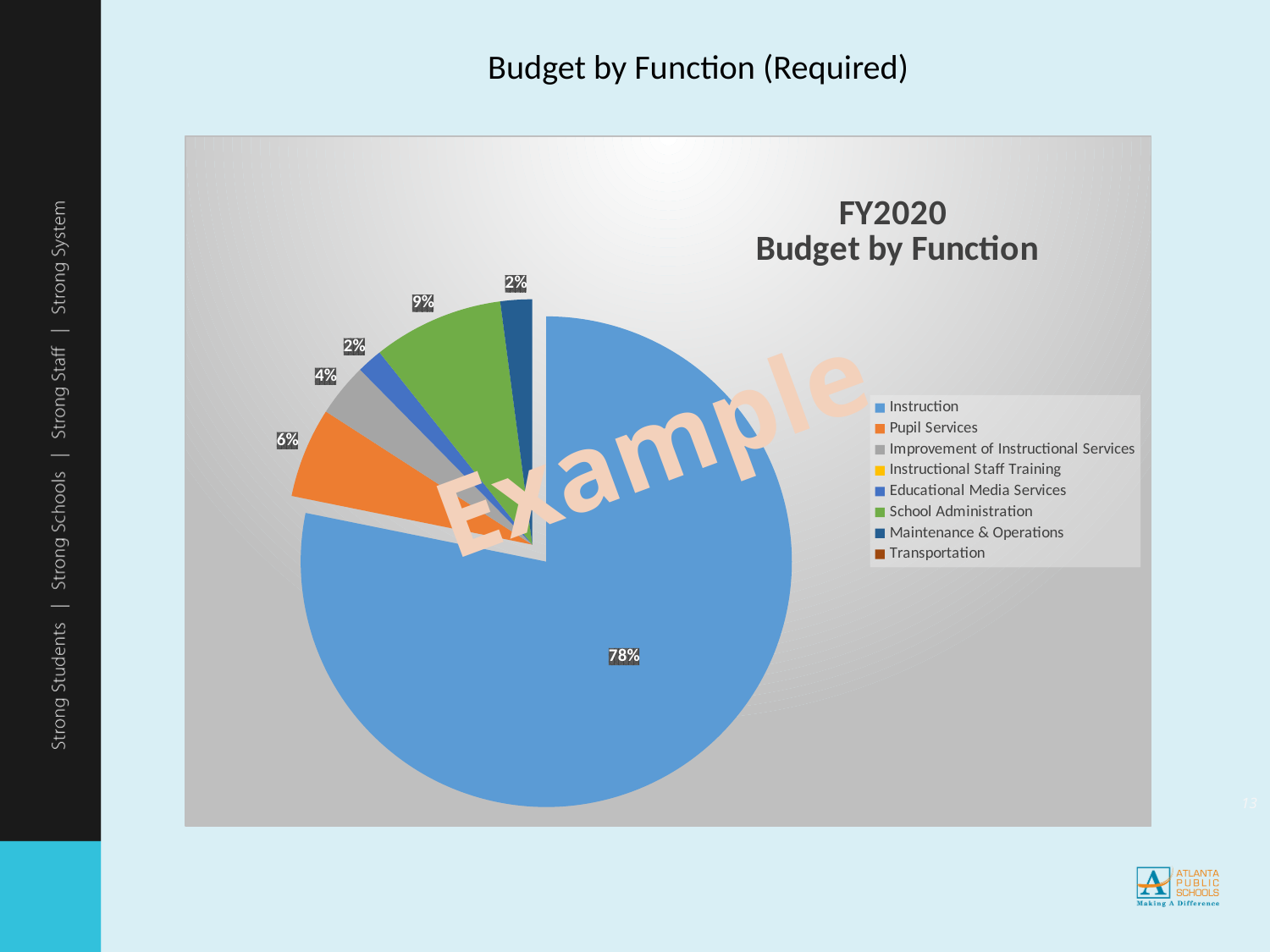
Which function has the largest share of the budget? Instruction What is the title of the chart? FY2020 Budget by Function How many entries does the legend list? 8 What share of the budget goes to Instruction? 78% What share of the budget goes to School Administration? 9% What share of the budget goes to Maintenance & Operations? 2% What share of the budget goes to Improvement of Instructional Services? 4% Which has a larger share, Pupil Services or School Administration? School Administration What kind of chart is shown on the slide? pie chart How many percentage points larger is the Instruction share than the School Administration share? 69 What colour is the Instruction slice? blue What share of the budget goes to Pupil Services? 6%